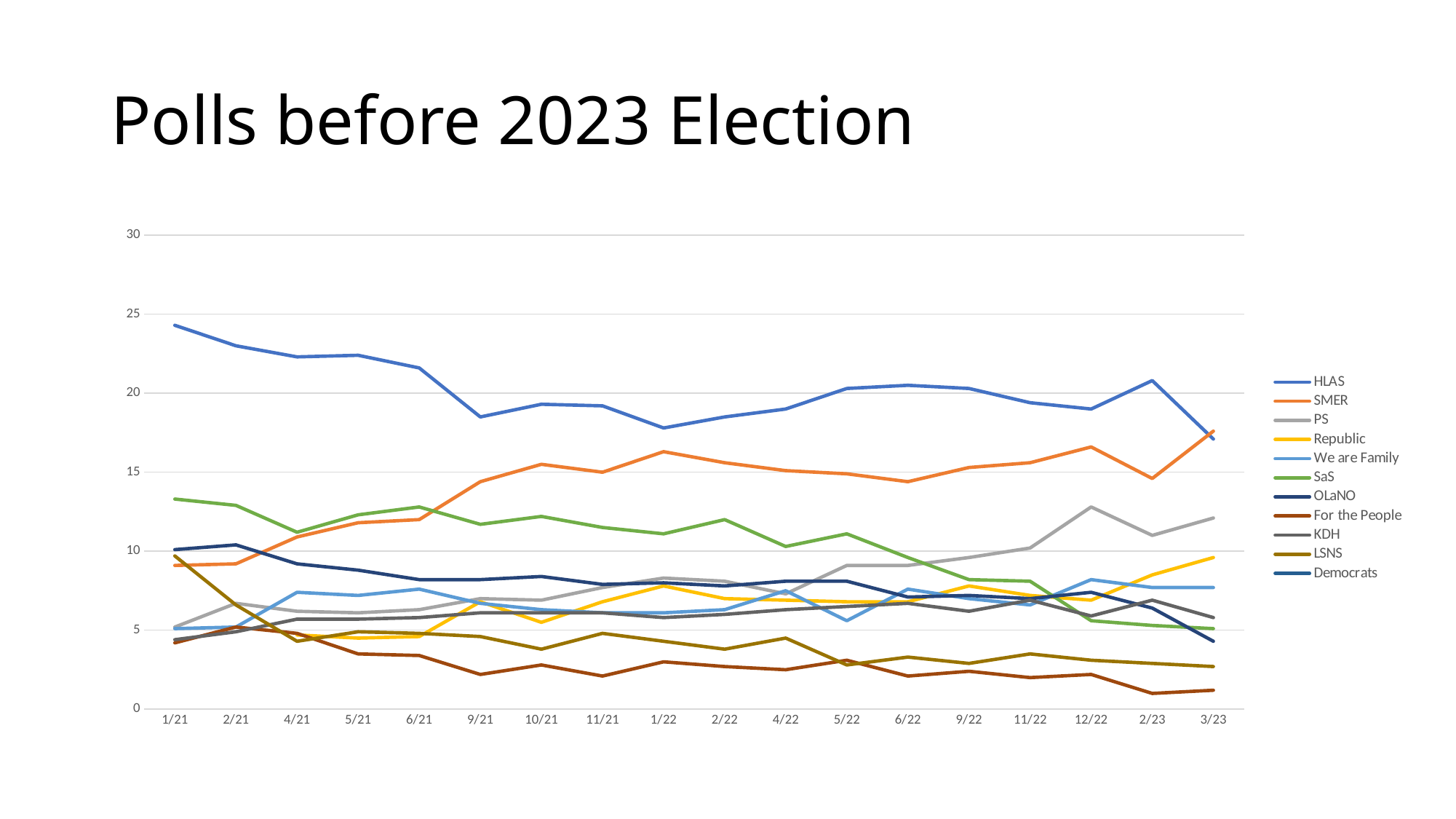
Is the value for HLAS at 1/21 greater or less than 20? greater What is the title of the chart? Polls before 2023 Election How many series does the legend list? 11 Is the value for For the People at 3/23 greater or less than 5? less How many poll dates are shown along the x axis? 18 Which party has the highest value at 1/21? HLAS Which is larger at 3/23, PS or SaS? PS What kind of chart is shown on the slide? line chart Is the value for SMER at 1/21 greater or less than 10? less Does the HLAS line rise or fall from 1/21 to 6/21? fall Which party has the lowest value at 3/23? For the People